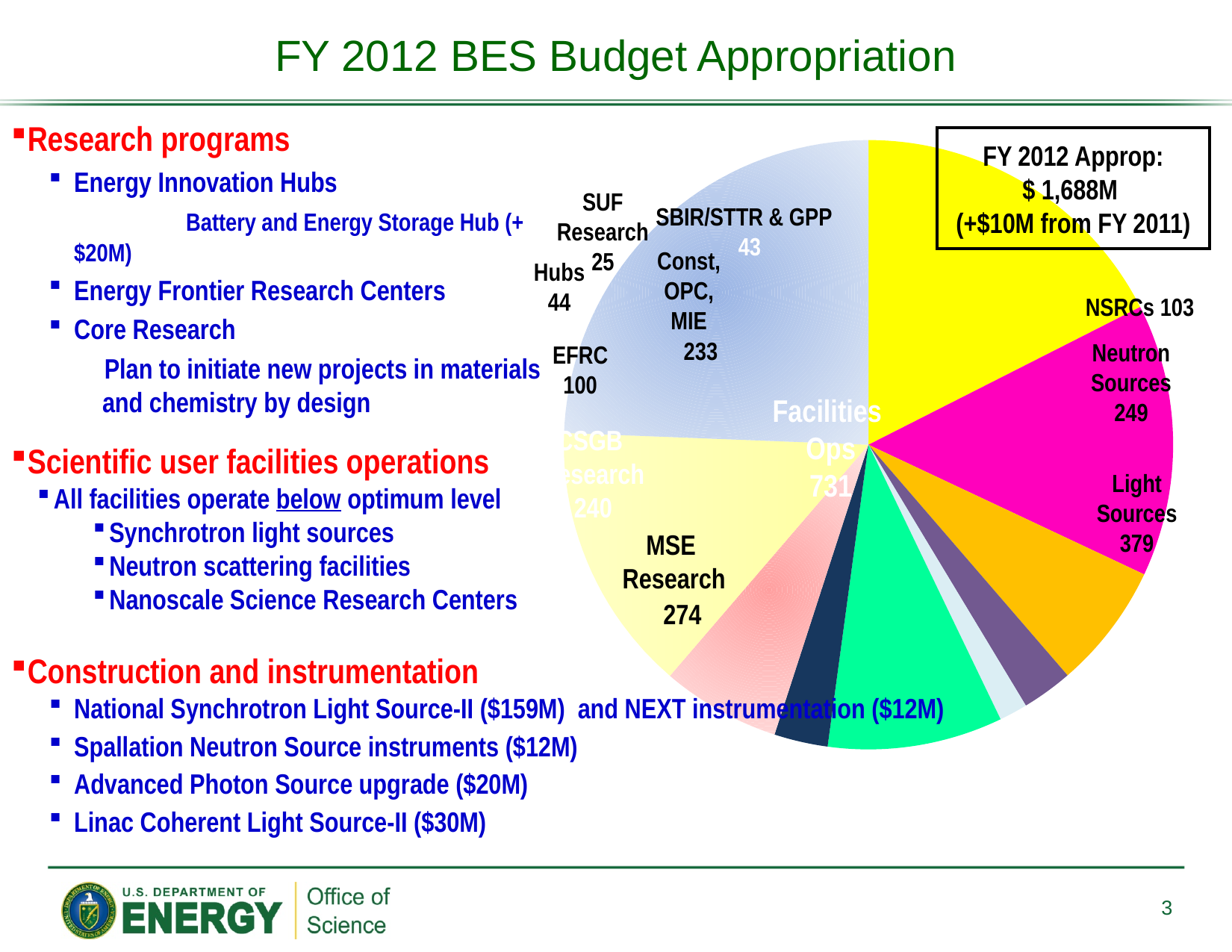
Which has the larger value, MSE Research or CSGB Research? MSE Research What value is shown for EFRC in the pie chart? 100 What value is shown for Const, OPC, MIE in the pie chart? 233 What is the difference between the values for Hubs and SBIR/STTR & GPP? 1 Which labelled item in the pie chart has the largest value? Facilities Ops What total FY 2012 appropriation is stated in the box next to the pie chart? $ 1,688M What value is shown for MSE Research in the pie chart? 274 What is the difference between the values for Light Sources and Neutron Sources? 130 What kind of chart is shown on the slide? pie chart What value is shown for Facilities Ops in the pie chart? 731 Which labelled item in the pie chart has the smallest value? SUF Research What value is shown for Light Sources in the pie chart? 379